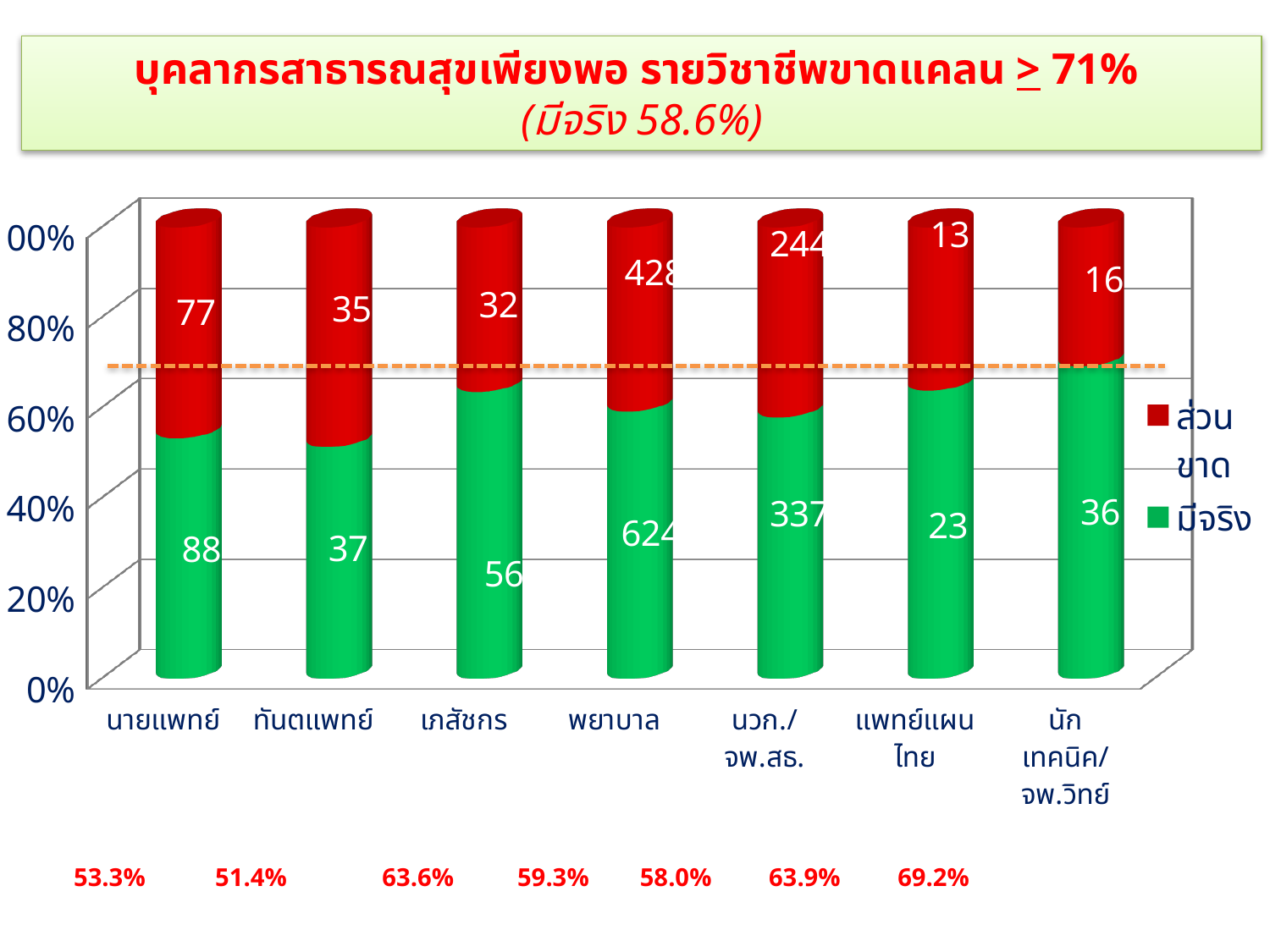
What is the value of ส่วนขาด for แพทย์แผนไทย? 13 What kind of chart is shown on the slide? Stacked bar chart How many series does the legend list? 2 What is the total of มีจริง and ส่วนขาด for เภสัชกร? 88 Which is larger for นักเทคนิค/จพ.วิทย์: มีจริง or ส่วนขาด? มีจริง What is the difference between มีจริง and ส่วนขาด for ทันตแพทย์? 2 Which category has the highest มีจริง value? พยาบาล How many categories are shown on the x axis? 7 What is the value of มีจริง for นวก./จพ.สธ.? 337 Which category has the lowest ส่วนขาด value? แพทย์แผนไทย What is the value of มีจริง for นายแพทย์? 88 What is the value of ส่วนขาด for พยาบาล? 428